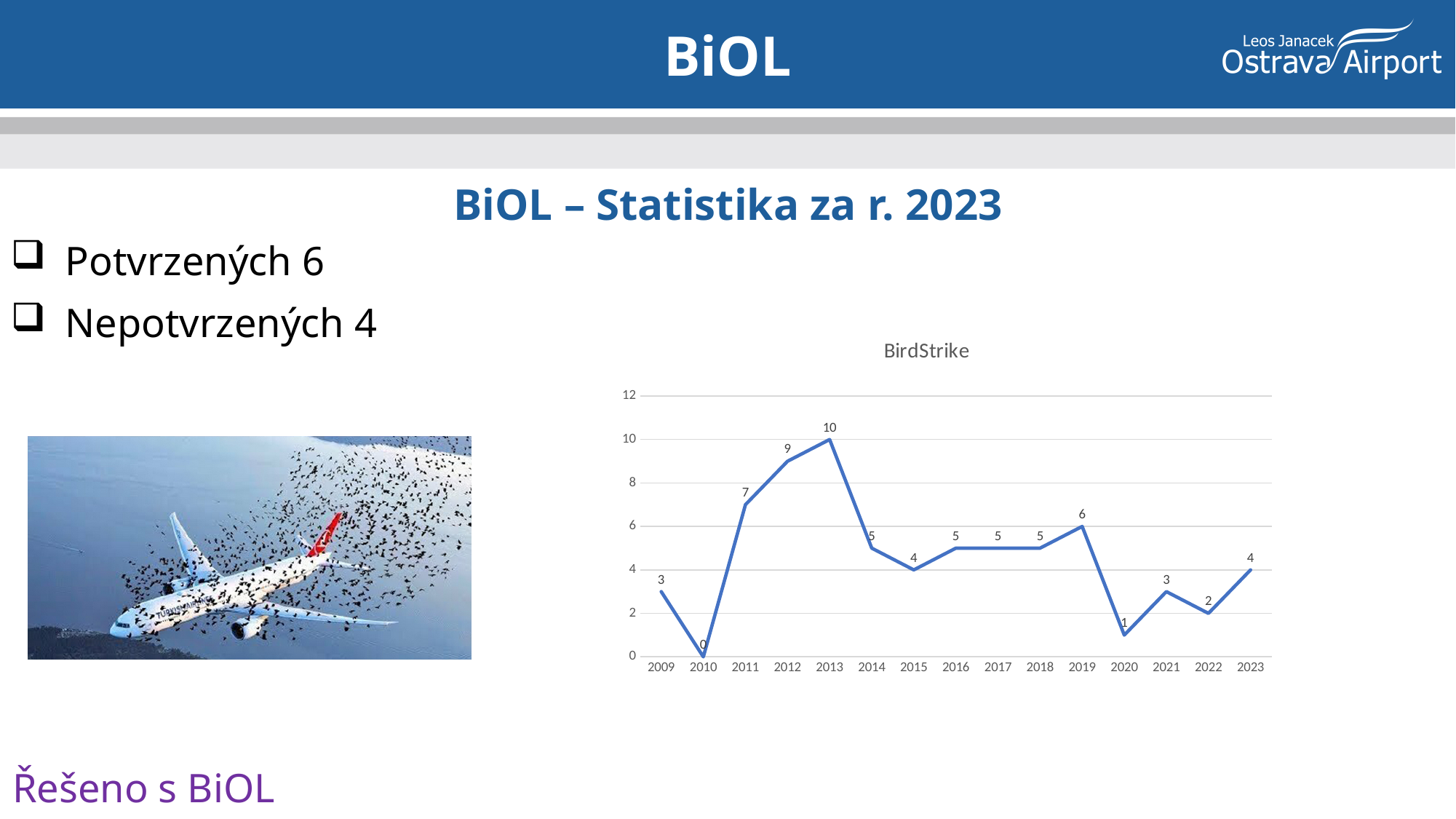
What is the BirdStrike value for 2010? 0 Do the BirdStrike values rise or fall from 2020 to 2023? rise Which year has a higher BirdStrike value, 2019 or 2022? 2019 Which year has the highest BirdStrike value? 2013 Which year has the lowest BirdStrike value? 2010 How many years are shown on the x axis of the BirdStrike chart? 15 What is the BirdStrike value for 2023? 4 What is the BirdStrike value for 2013? 10 What is the difference between the BirdStrike values for 2013 and 2020? 9 What kind of chart is the BirdStrike chart? line chart What is the difference between the BirdStrike values for 2011 and 2012? 2 What is the title of the chart on the slide? BirdStrike